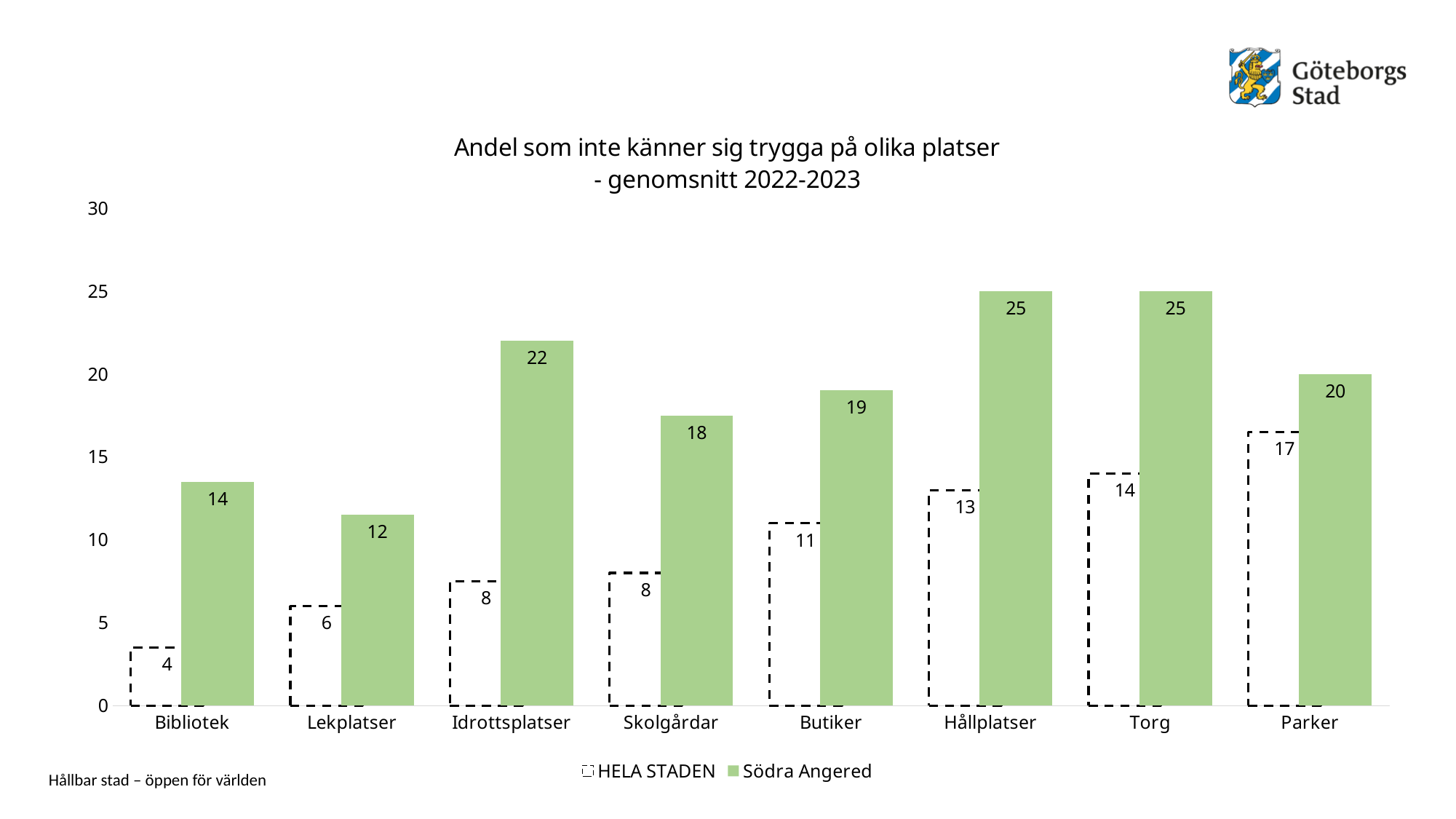
What is the value for HELA STADEN at Bibliotek? 4 Is the value for Södra Angered at Torg greater or less than 20? greater What kind of chart is shown on the slide? Bar chart How many categories are shown on the x axis? 8 Which category has the lowest value for Södra Angered? Lekplatser Which category has the highest value for HELA STADEN? Parker What is the value for Södra Angered at Idrottsplatser? 22 What is the difference between Södra Angered and HELA STADEN at Butiker? 8 What is the title of the chart? Andel som inte känner sig trygga på olika platser - genomsnitt 2022-2023 How many series does the legend list? 2 Which is larger at Skolgårdar: the value for HELA STADEN or for Södra Angered? Södra Angered What is the value for HELA STADEN at Parker? 17